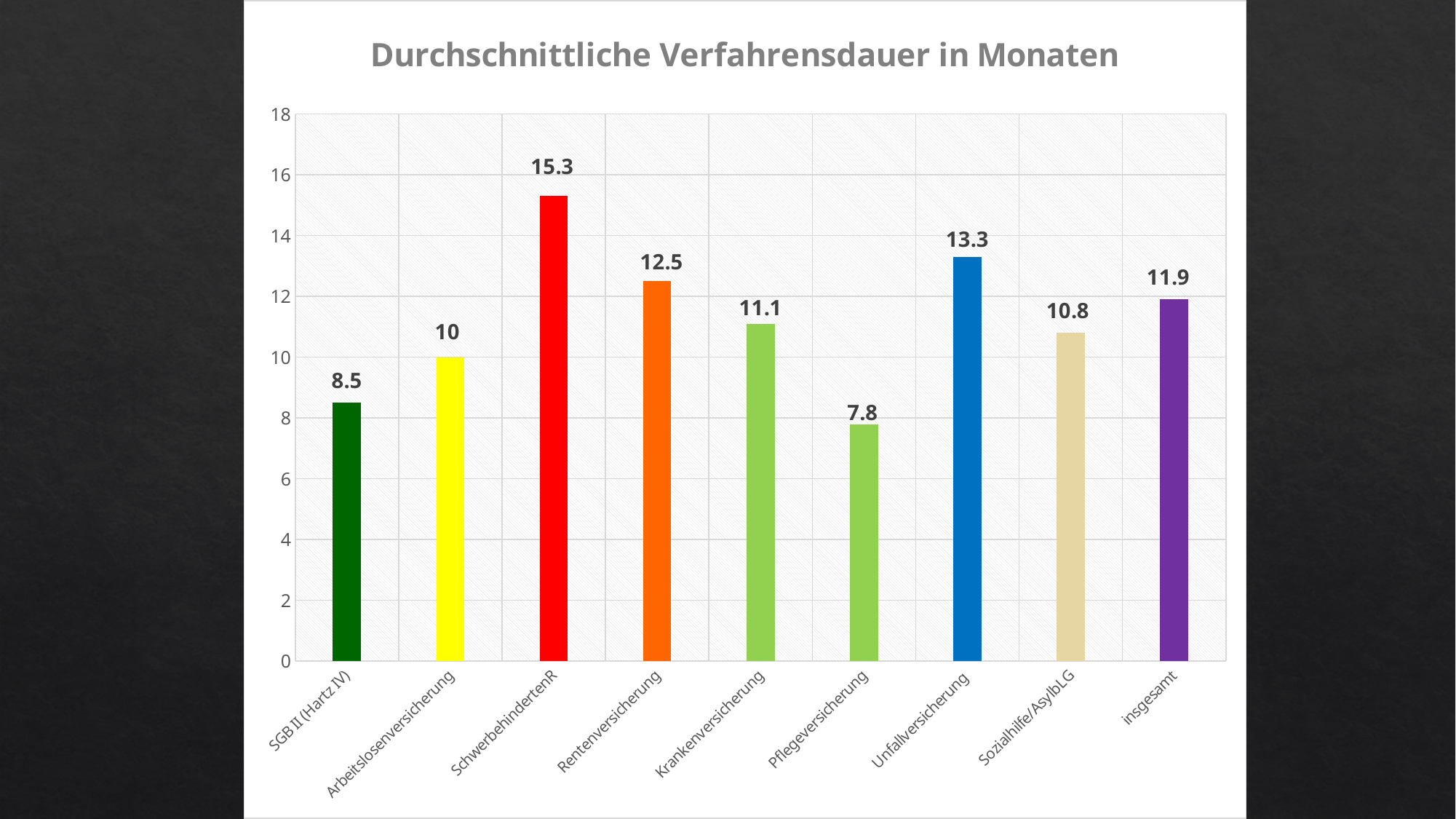
What is the difference between the values for Unfallversicherung and Rentenversicherung? 0.8 Which is larger, the value for Krankenversicherung or the value for Sozialhilfe/AsylbLG? Krankenversicherung What is the title of the chart? Durchschnittliche Verfahrensdauer in Monaten What kind of chart is this? bar chart What is the value for Arbeitslosenversicherung? 10 Which category has the lowest value? Pflegeversicherung How many categories are shown on the x axis? 9 Which category has the highest value? SchwerbehindertenR What is the value for Pflegeversicherung? 7.8 What is the value for SchwerbehindertenR? 15.3 What is the value for insgesamt? 11.9 Is the value for SGB II (Hartz IV) greater or less than 10? less